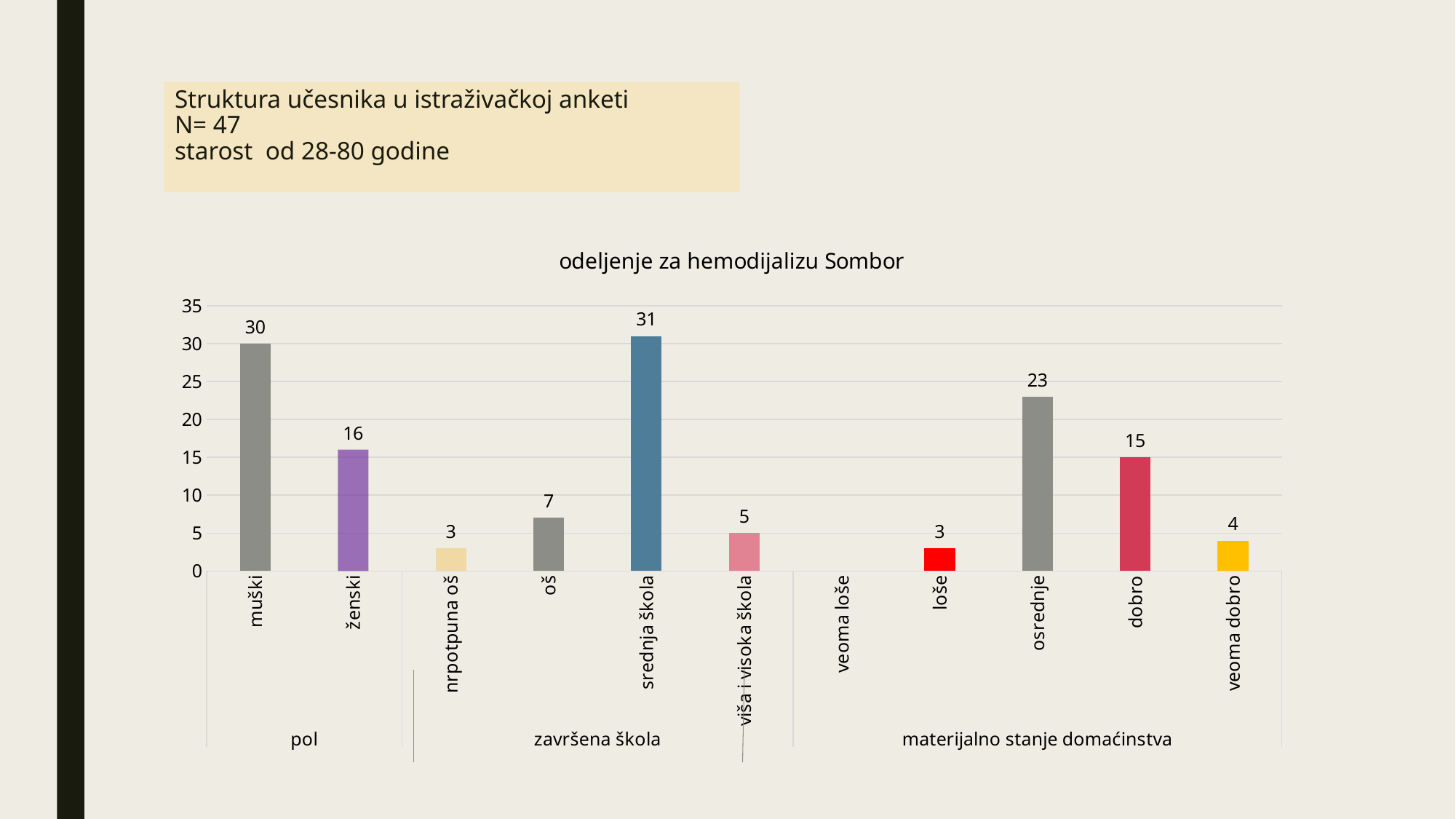
What is the value for srednja škola? 31 What is the title of the chart? odeljenje za hemodijalizu Sombor What is the difference between osrednje and dobro? 8 Which is larger, the value for oš or the value for veoma dobro? oš Is the value for ženski greater or less than 20? less Within the pol group, what is the difference between muški and ženski? 14 What is the value for muški? 30 How many category labels are shown on the x axis? 11 What kind of chart is shown? bar chart Which category has the highest value? srednja škola What is the value for osrednje? 23 What is the value for viša i visoka škola? 5